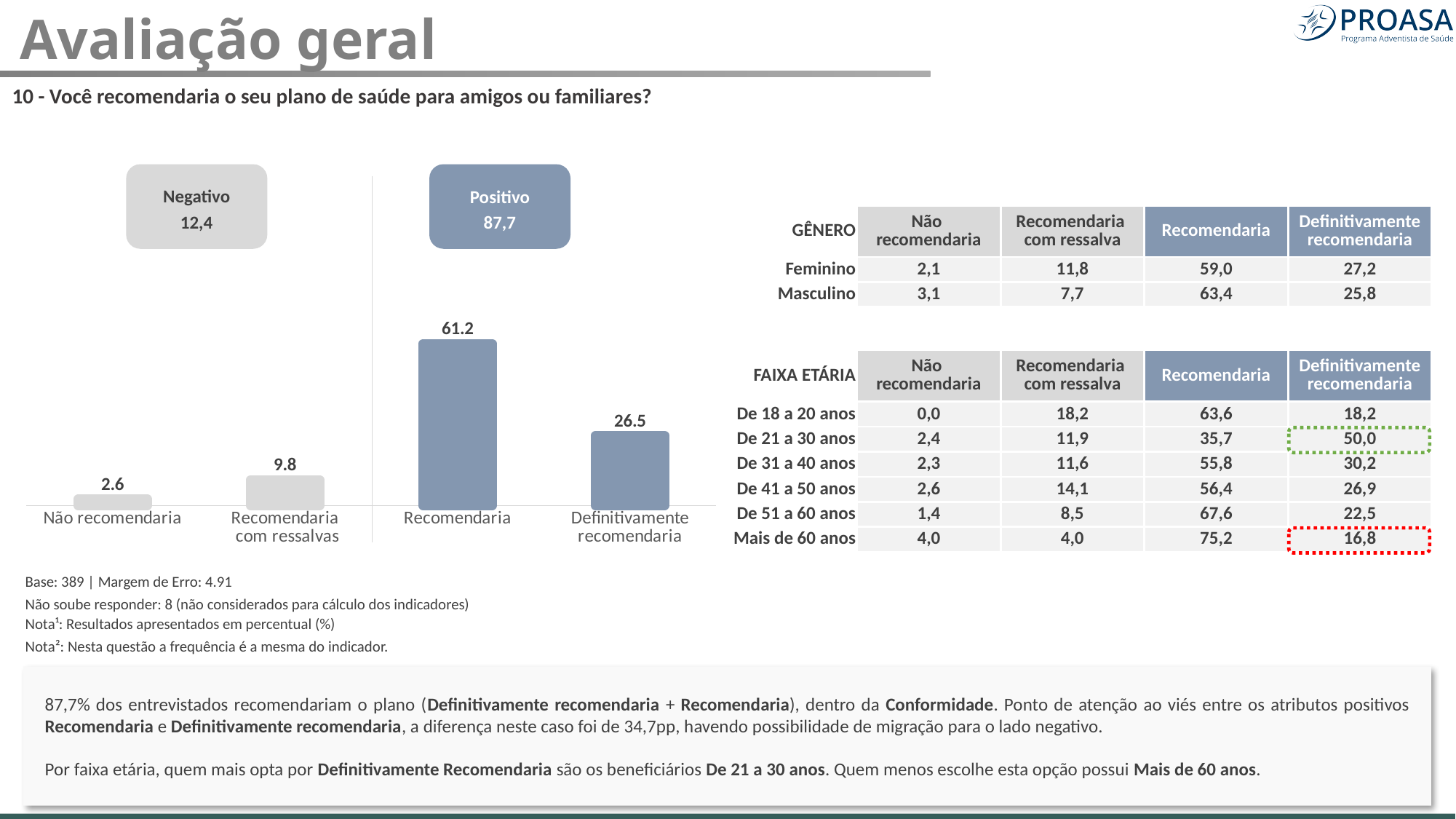
What is the value for Recomendaria in the bar chart? 61.2 How many categories are shown in the bar chart? 4 What is the value for Definitivamente recomendaria in the bar chart? 26.5 What is the difference between the values for Recomendaria com ressalvas and Não recomendaria in the bar chart? 7.2 What is the value for Não recomendaria in the bar chart? 2.6 Which category has the highest value in the bar chart? Recomendaria What is the difference between the values for Recomendaria and Definitivamente recomendaria in the bar chart? 34.7 What value is shown in the Positivo box above the bar chart? 87,7 What is the value for Recomendaria com ressalvas in the bar chart? 9.8 Which is larger in the bar chart: Recomendaria com ressalvas or Definitivamente recomendaria? Definitivamente recomendaria Which category has the lowest value in the bar chart? Não recomendaria What kind of chart is shown on the slide? Bar chart